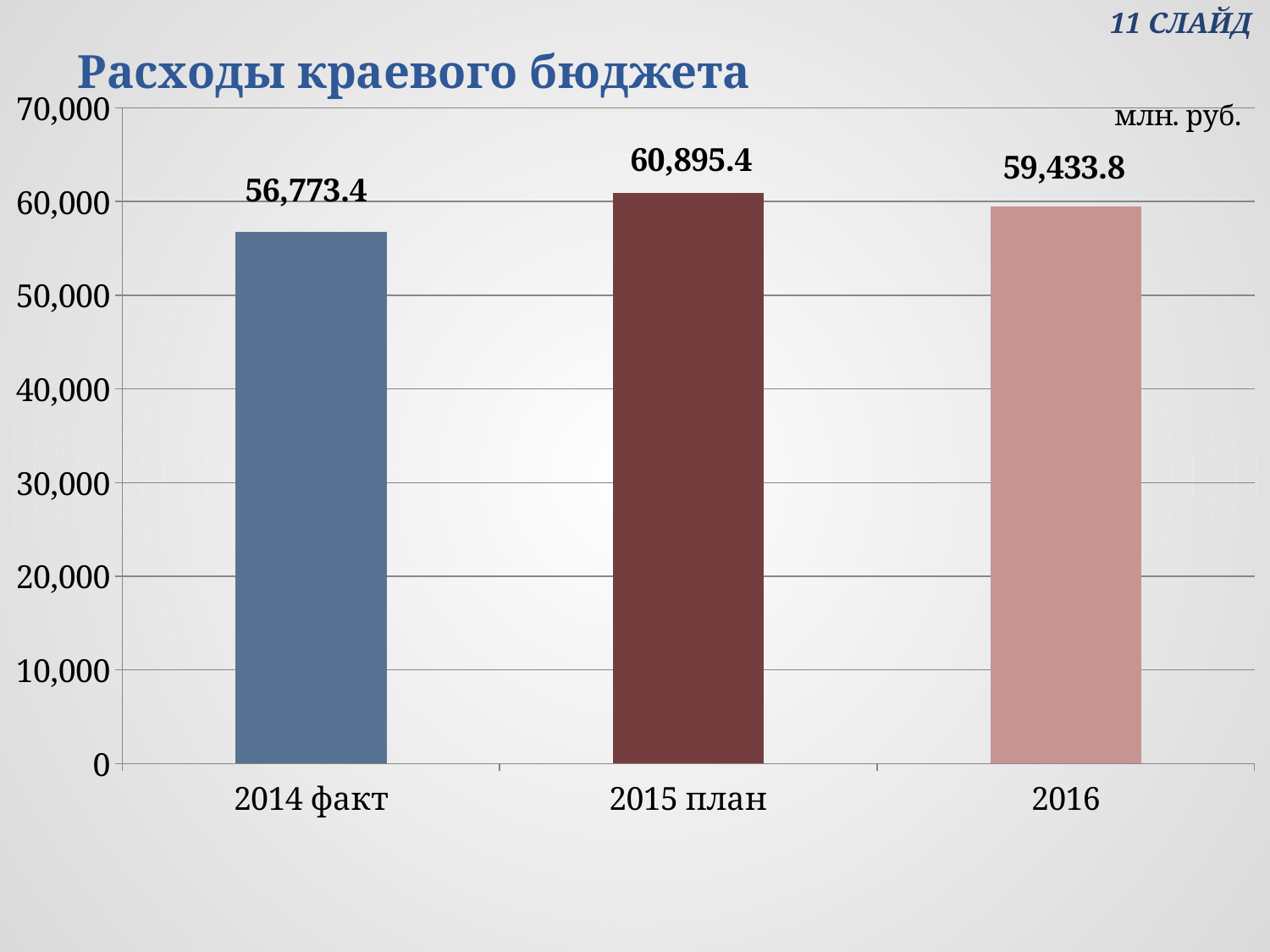
What kind of chart is shown on the slide? bar chart Is the value for 2014 факт greater or less than 60,000? less What unit of measurement is indicated on the chart? млн. руб. What is the value for 2016? 59,433.8 What is the difference between the values for 2015 план and 2014 факт? 4,122.0 What is the value for 2015 план? 60,895.4 How many categories are shown on the x axis? 3 What is the difference between the values for 2015 план and 2016? 1,461.6 What is the value for 2014 факт? 56,773.4 Which is larger, the value for 2016 or the value for 2014 факт? 2016 Which category has the highest value? 2015 план Which category has the lowest value? 2014 факт